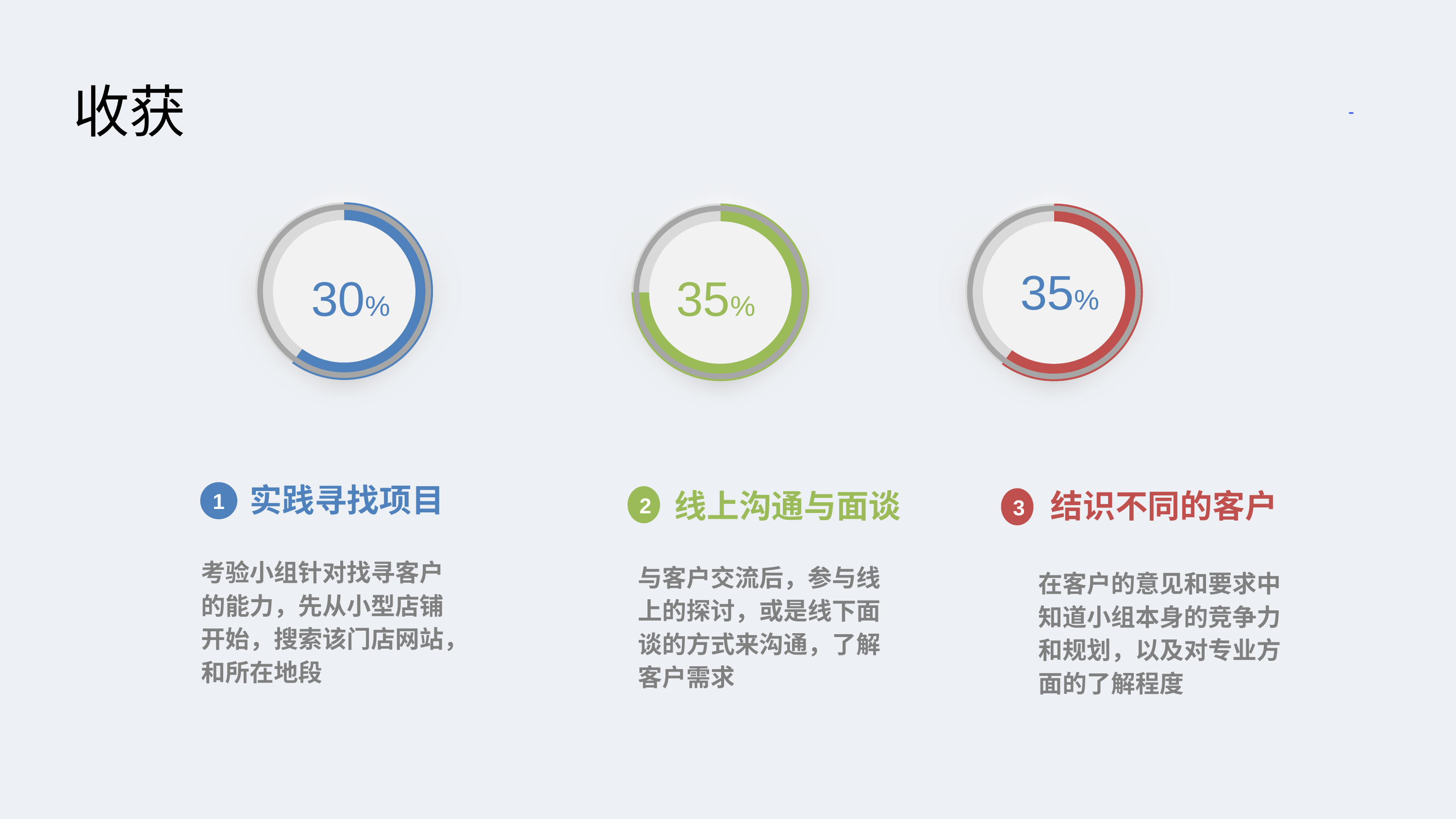
What percentage is shown in the right ring chart, labelled 结识不同的客户? 35% How many ring charts are shown on the slide? 3 What percentage is shown in the middle ring chart, labelled 线上沟通与面谈? 35% Which of the three ring charts shows the lowest percentage? 实践寻找项目 (30%) What percentage is shown in the left ring chart, labelled 实践寻找项目? 30% Which is larger: the percentage for 实践寻找项目 or the percentage for 结识不同的客户? 结识不同的客户 What is the title of the slide containing the three ring charts? 收获 What kind of chart is used to display the three percentages on the slide? Ring (donut) chart What colour is the ring chart for 线上沟通与面谈? Green What is the total of the three percentages shown in the ring charts? 100% What is the difference between the percentage in the middle ring chart (线上沟通与面谈) and the left ring chart (实践寻找项目)? 5% Do the middle and right ring charts show the same percentage? Yes, both 35%